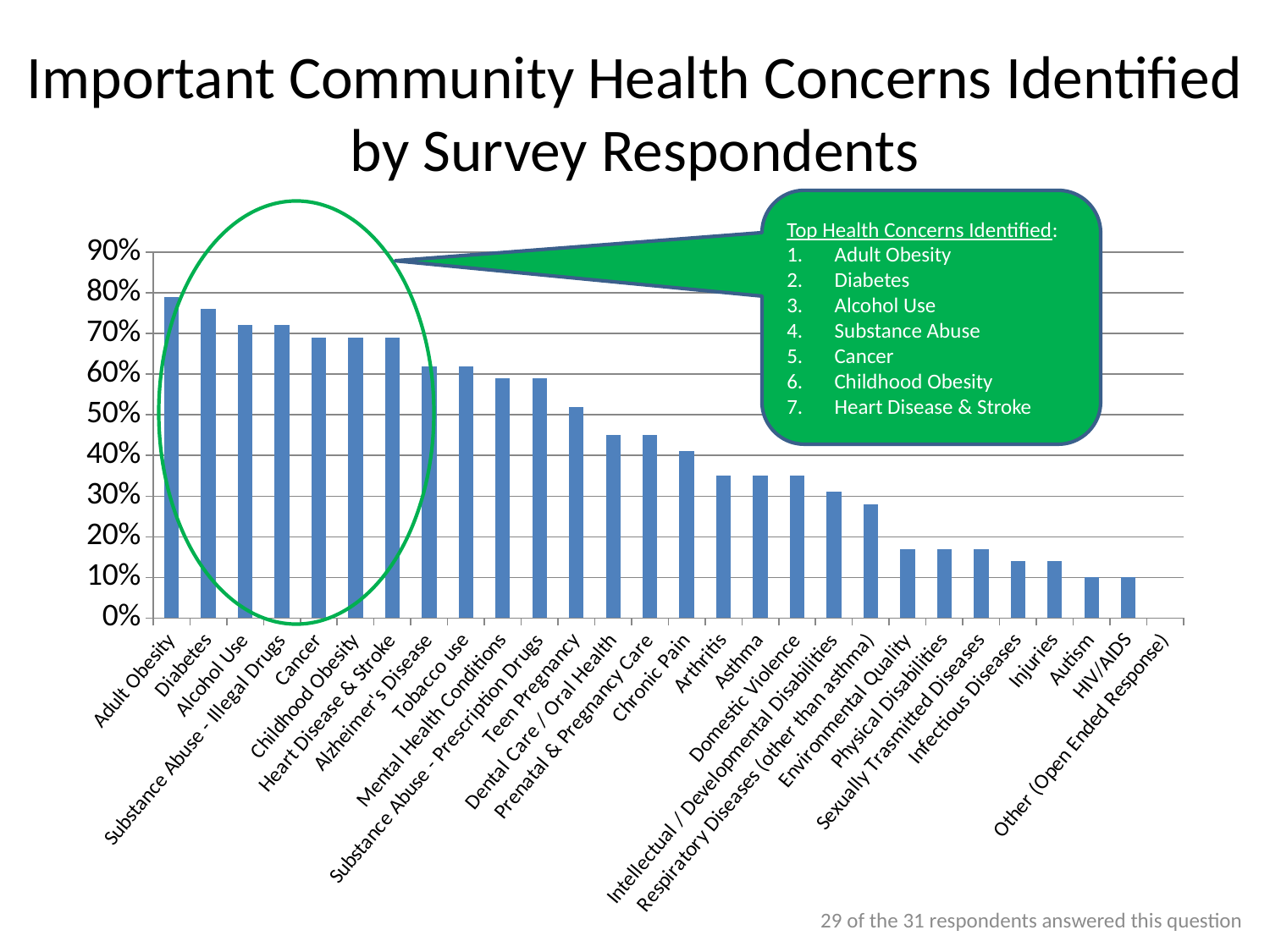
Do the bar values generally rise or fall from left to right along the x axis? Fall Is the value for Arthritis greater or less than 40%? less Is the value for Teen Pregnancy greater or less than 60%? less Which is larger, the value for Tobacco use or the value for Arthritis? Tobacco use Which is larger, the value for Diabetes or the value for Alcohol Use? Diabetes What kind of chart is shown on the slide? Bar chart Which health concern has the highest bar? Adult Obesity Is the value for Adult Obesity greater or less than 70%? greater How many top health concerns are listed in the green callout box? 7